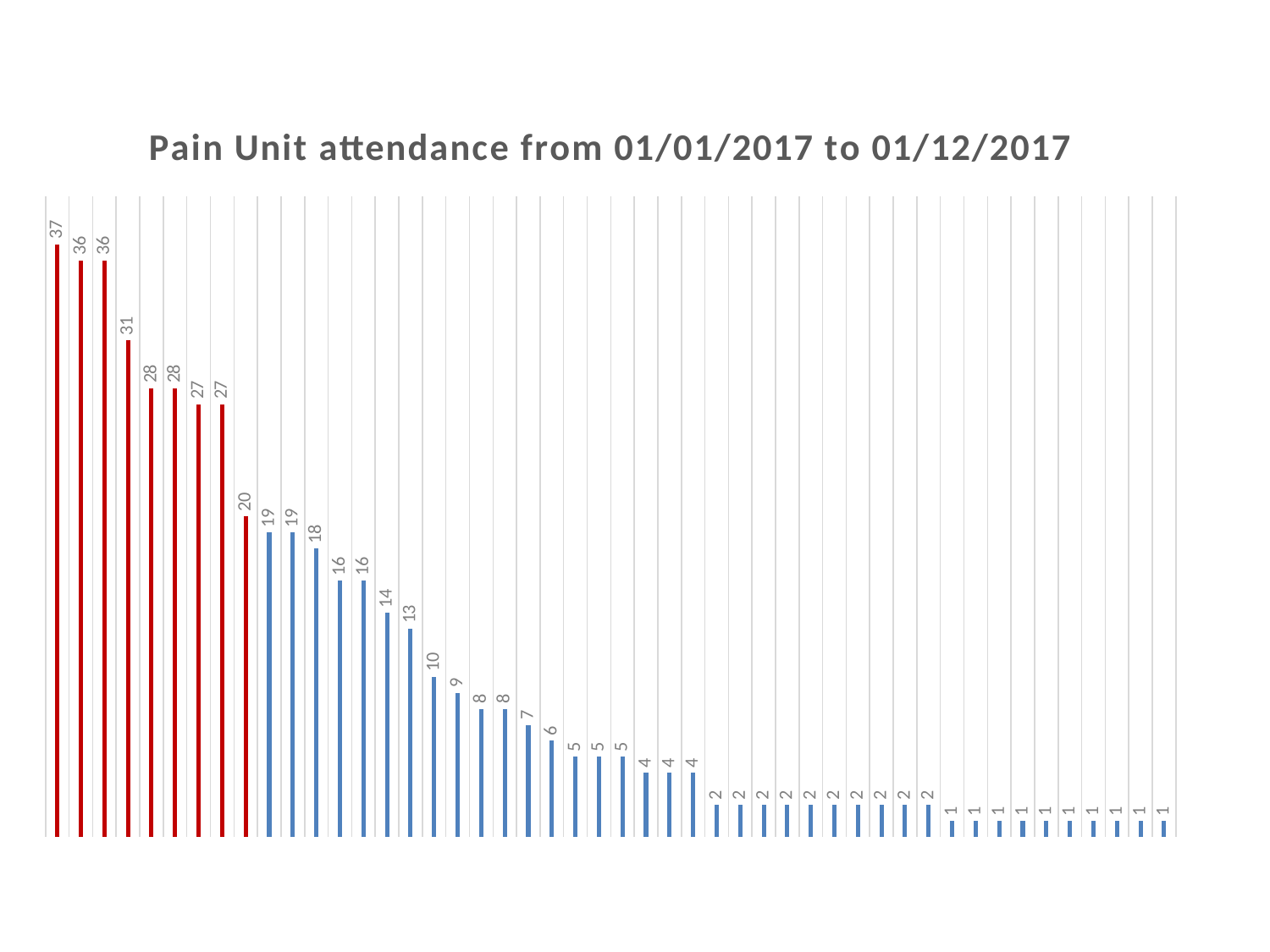
What is the value of the tallest blue bar? 19 What is the title of the chart? Pain Unit attendance from 01/01/2017 to 01/12/2017 Do the bar values rise or fall from left to right across the chart? fall What kind of chart is shown on the slide? bar chart What is the value of the shortest red bar? 20 Which is larger, the value of the first bar on the left (37) or the value of the fourth bar (31)? the first bar (37) How many bars are there in total in the chart? 48 What is the highest value shown in the chart? 37 How many bars are coloured red in the chart? 9 What is the difference between the highest value (37) and the lowest value (1) in the chart? 36 How many bars have a value of 2? 10 What is the lowest value shown in the chart? 1